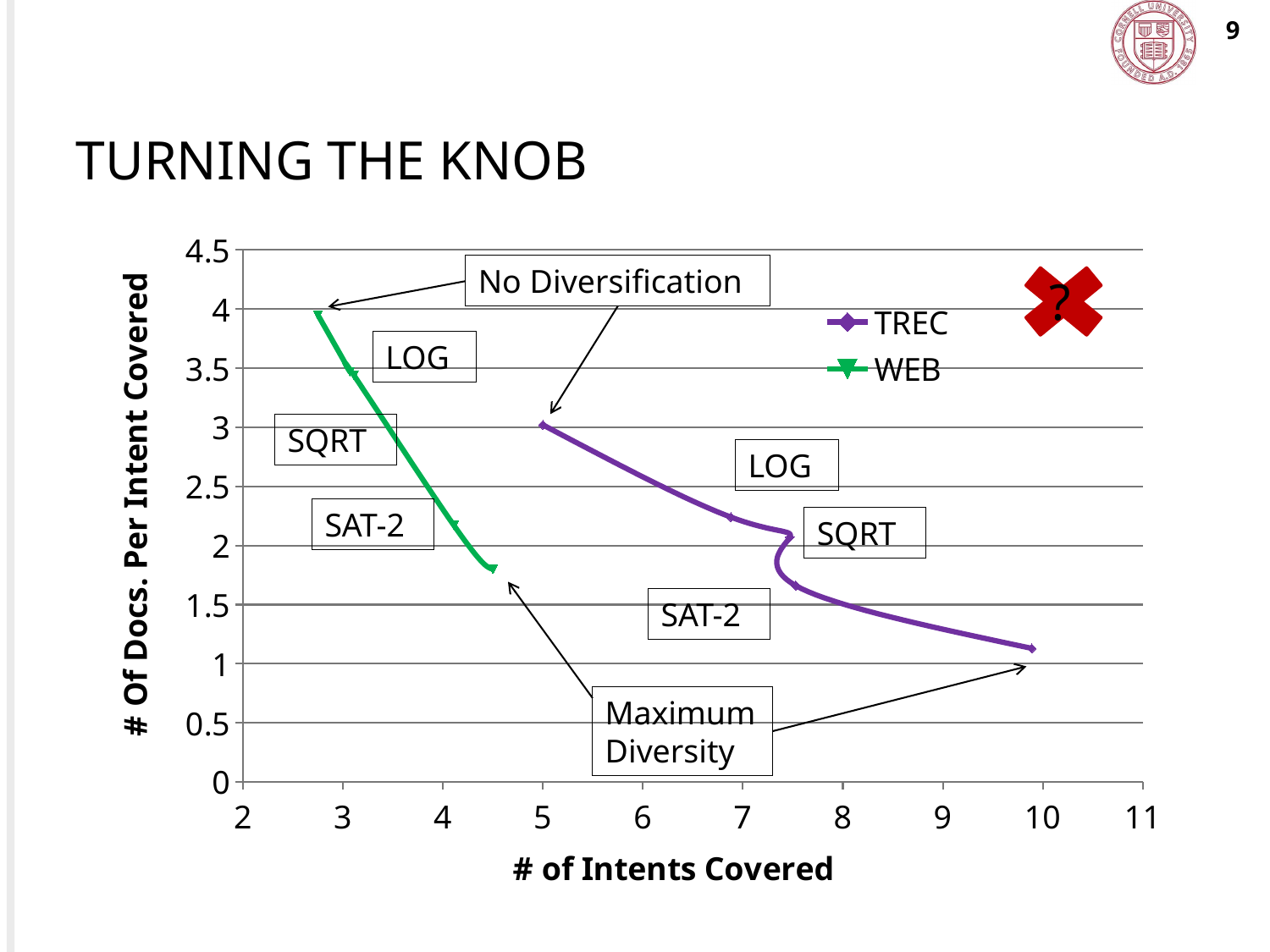
Is the y value of the WEB series at its No Diversification point greater or less than 3.5? greater What are the two series named in the chart legend? TREC and WEB Is the y value of the TREC series at its No Diversification point greater or less than 2.5? greater Which series has a higher number of docs per intent covered at its No Diversification point, TREC or WEB? WEB Is the x value of the TREC series at its Maximum Diversity point greater or less than 9? greater What kind of chart is shown on the slide? line chart What is the title of the x axis of the chart? # of Intents Covered How many series does the chart legend list? 2 Which series reaches a higher number of intents covered at its Maximum Diversity point, TREC or WEB? TREC As the number of intents covered increases along the x axis, does the number of docs per intent covered rise or fall for the TREC series? fall